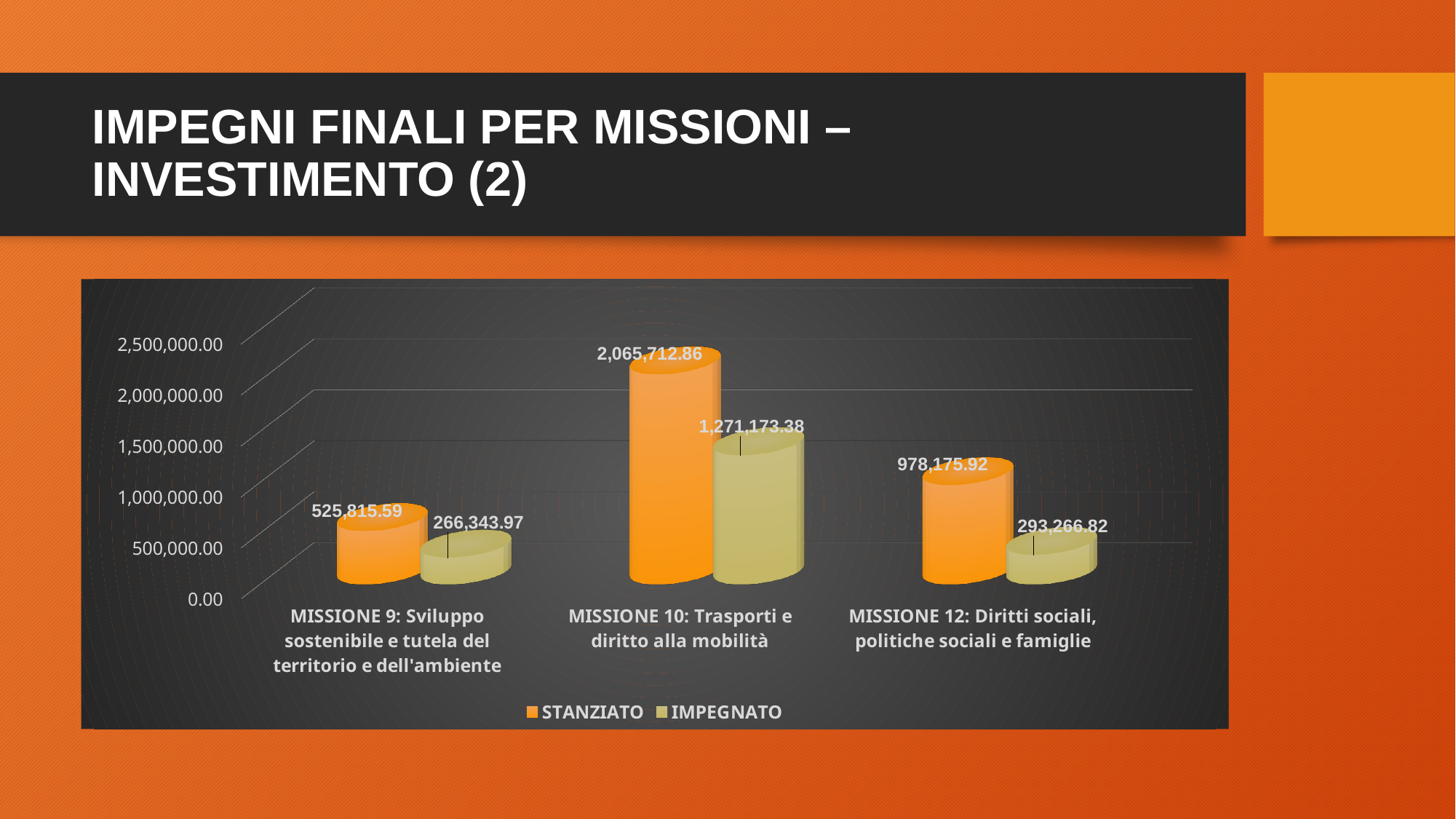
Which mission has the highest STANZIATO value? MISSIONE 10: Trasporti e diritto alla mobilità What is the STANZIATO value for MISSIONE 12: Diritti sociali, politiche sociali e famiglie? 978,175.92 Which mission has the lowest IMPEGNATO value? MISSIONE 9: Sviluppo sostenibile e tutela del territorio e dell'ambiente What is the STANZIATO value for MISSIONE 10: Trasporti e diritto alla mobilità? 2,065,712.86 What is the IMPEGNATO value for MISSIONE 9: Sviluppo sostenibile e tutela del territorio e dell'ambiente? 266,343.97 How many missions (categories) are shown on the chart? 3 What is the difference between the STANZIATO and IMPEGNATO values for MISSIONE 10? 794,539.48 What kind of chart is shown on the slide? Bar chart What is the IMPEGNATO value for MISSIONE 12: Diritti sociali, politiche sociali e famiglie? 293,266.82 Is the STANZIATO value for MISSIONE 9 greater or less than 1,000,000.00? less Which is larger for MISSIONE 12: the STANZIATO value or the IMPEGNATO value? STANZIATO How many series does the legend list? 2